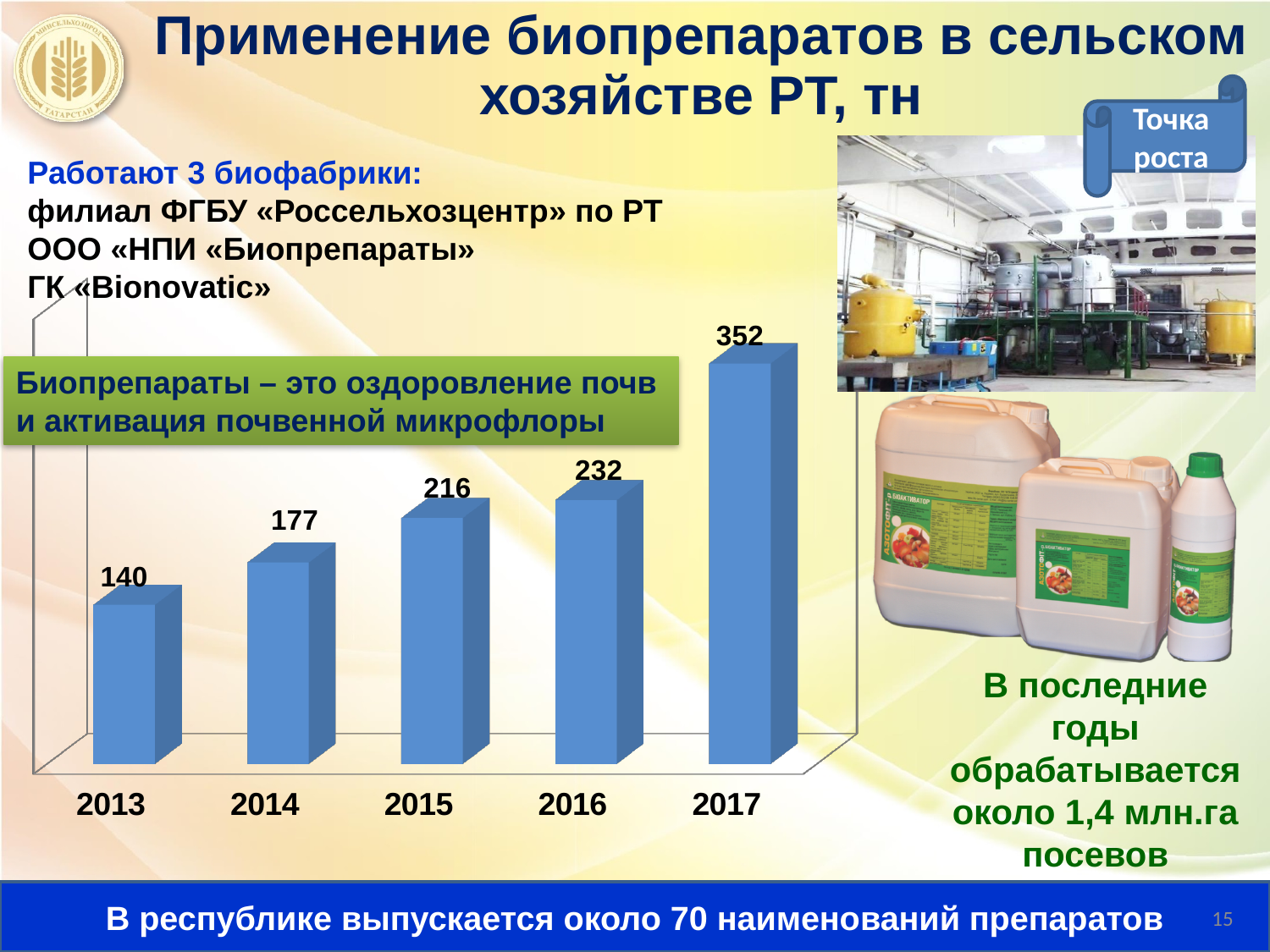
What is the title of the chart on the slide? Применение биопрепаратов в сельском хозяйстве РТ, тн What was the value for 2017? 352 Do the values rise or fall from 2013 to 2017? rise What kind of chart is shown on the slide? bar chart Which year has the lowest value? 2013 What was the value for 2013? 140 How many years are shown on the chart? 5 Which year has the highest value? 2017 What was the value for 2015? 216 Which is larger, the value for 2015 or the value for 2016? 2016 What is the difference between the values for 2017 and 2016? 120 What is the difference between the values for 2014 and 2013? 37